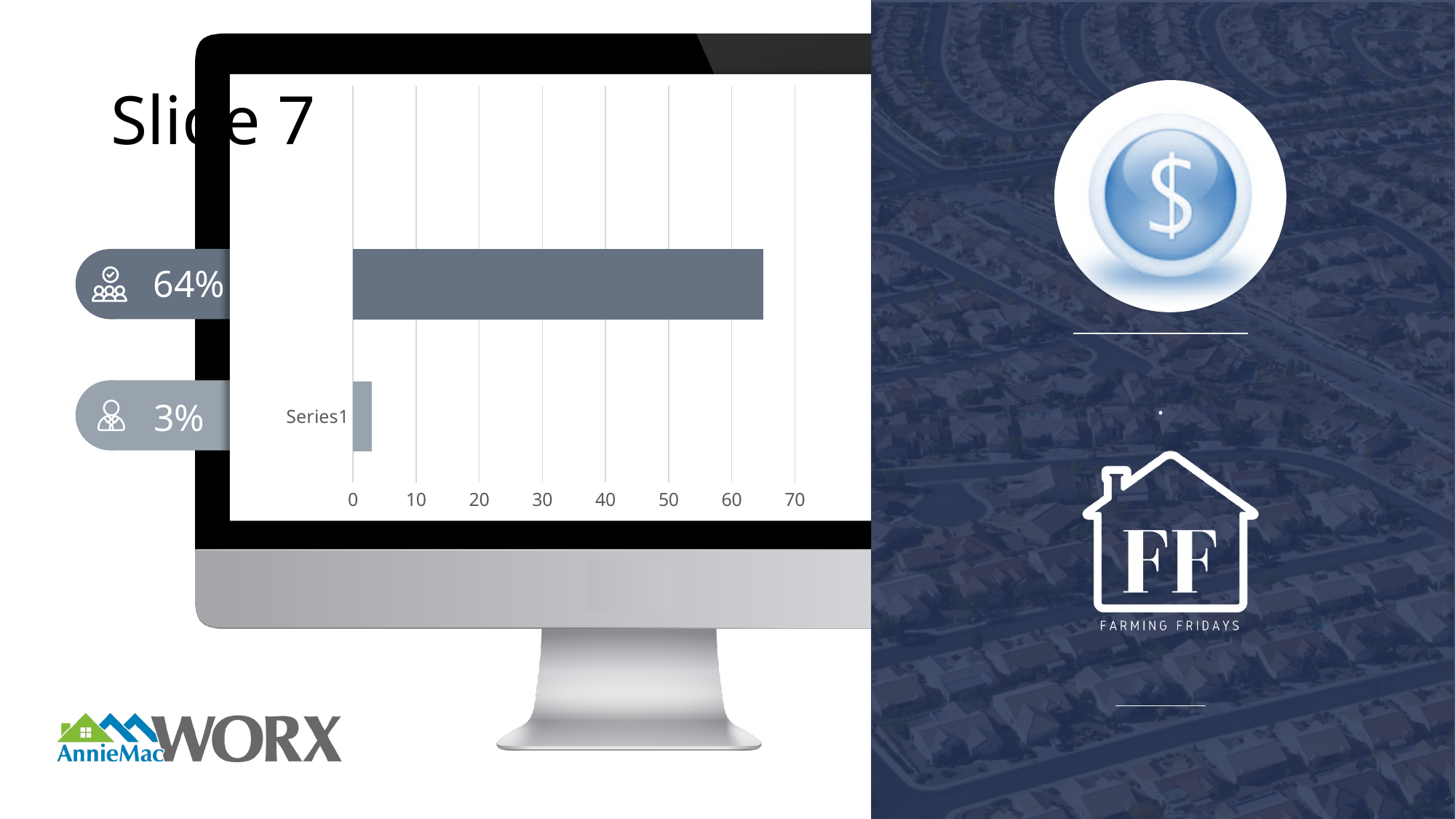
Is the value of the lower bar labelled Series1 greater or less than 10? less What is the interval between tick marks on the horizontal axis? 10 Which bar is longer, the upper bar or the lower bar labelled Series1? the upper bar How many bars are plotted in the chart? 2 What percentage is shown in the pill next to the lower bar? 3% What percentage is shown in the pill next to the upper bar? 64% Is the value of the upper bar greater or less than 60? greater What is the highest tick value shown on the horizontal axis? 70 Which bar has the lowest value in the chart? the lower bar (Series1) What kind of chart is shown on the monitor screen? bar chart Is the value of the upper bar greater or less than 70? less